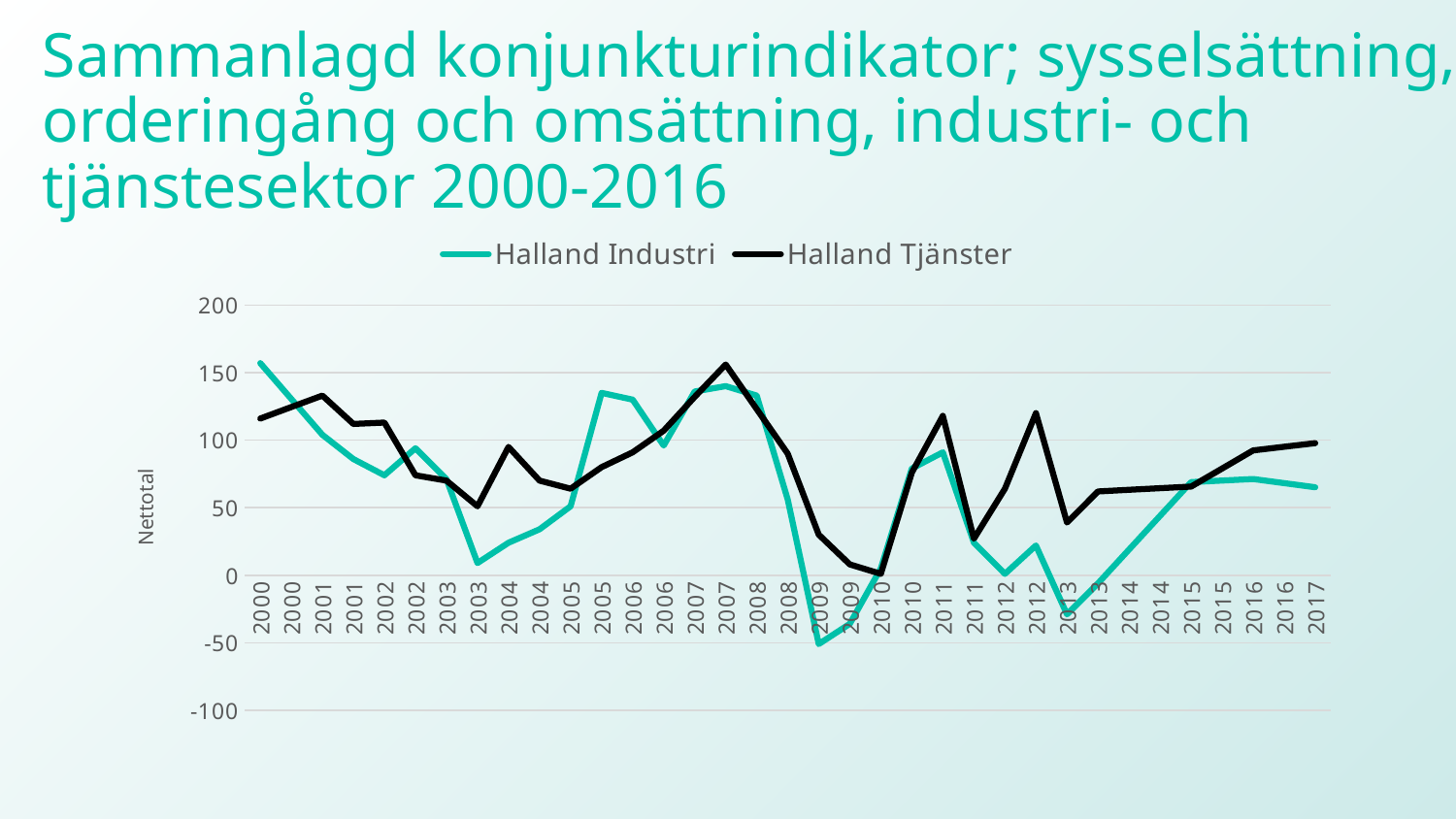
At the second 2005 point, which series has the larger value, Halland Industri or Halland Tjänster? Halland Industri In which year does Halland Industri reach its lowest value? 2009 What are the two series named in the legend? Halland Industri and Halland Tjänster What is the label on the vertical axis? Nettotal Is the value for Halland Industri at the first 2009 point greater or less than 0? less At the first 2009 point, which series has the larger value, Halland Industri or Halland Tjänster? Halland Tjänster Is the value for Halland Industri at the first 2000 point greater or less than 150? greater Is the value for Halland Industri at the second 2003 point greater or less than 50? less How many series does the legend list? 2 What kind of chart is shown on the slide? line chart Does the Halland Industri line rise or fall between 2013 and 2015? rise